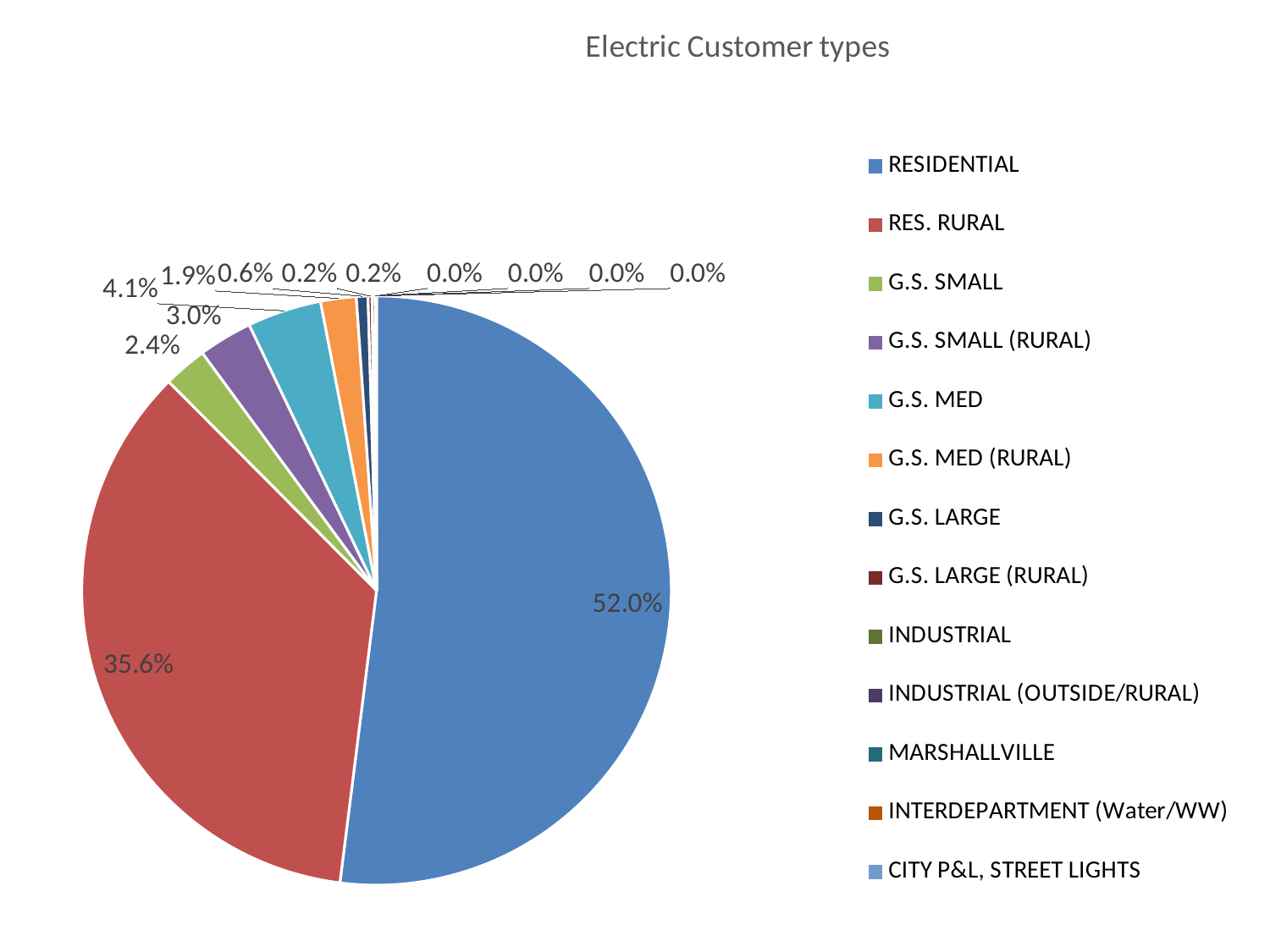
What is the title of the chart? Electric Customer types What type of chart is shown on the slide? Pie chart What percentage is shown for G.S. MED (RURAL)? 1.9% What is the difference in percentage points between RESIDENTIAL and RES. RURAL? 16.4% Which customer type has the largest share of the pie? RESIDENTIAL How many customer types are listed in the legend? 13 Which is larger, the share for G.S. MED or the share for G.S. SMALL (RURAL)? G.S. MED What percentage is shown for G.S. SMALL? 2.4% What percentage is shown for G.S. MED? 4.1% What percentage is shown for RES. RURAL? 35.6% What share of the pie does RESIDENTIAL account for? 52.0% What percentage is shown for G.S. SMALL (RURAL)? 3.0%